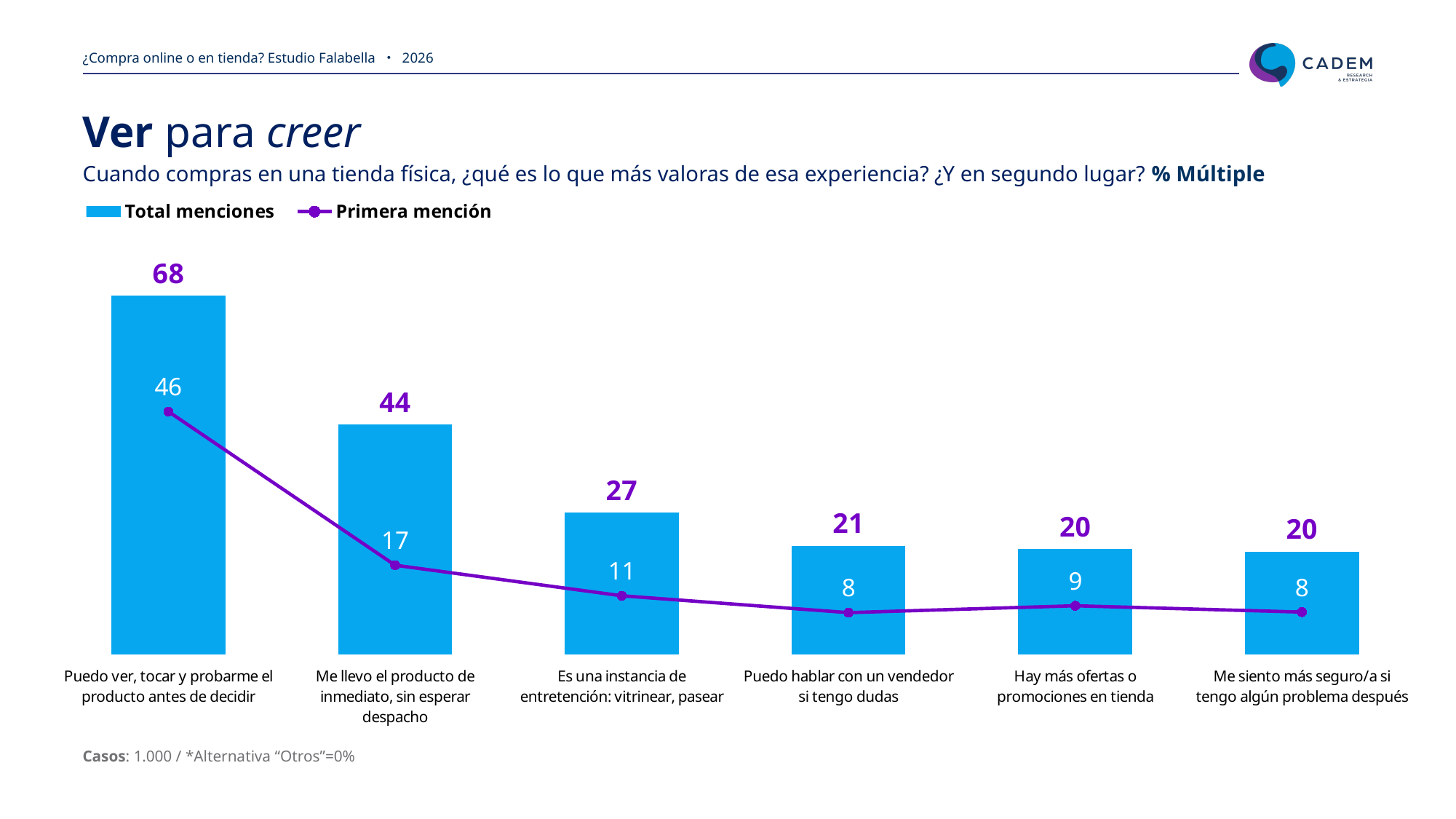
How many categories are shown on the x axis of the chart? 6 What is the Total menciones value for "Puedo ver, tocar y probarme el producto antes de decidir"? 68 What is the Primera mención value for "Me llevo el producto de inmediato, sin esperar despacho"? 17 Do the Total menciones values rise or fall from left to right along the x axis? Fall What is the difference between the Total menciones values for "Puedo ver, tocar y probarme el producto antes de decidir" and "Me llevo el producto de inmediato, sin esperar despacho"? 24 Which category has the highest Total menciones value? Puedo ver, tocar y probarme el producto antes de decidir What is the Total menciones value for "Es una instancia de entretención: vitrinear, pasear"? 27 What is the Primera mención value for "Hay más ofertas o promociones en tienda"? 9 Which category has the lowest Primera mención value? Puedo hablar con un vendedor si tengo dudas and Me siento más seguro/a si tengo algún problema después (both 8) How many series does the legend list? 2 Which is larger: the Primera mención value for "Es una instancia de entretención: vitrinear, pasear" or for "Hay más ofertas o promociones en tienda"? Es una instancia de entretención: vitrinear, pasear What kind of chart is used to show the Total menciones series? Bar chart